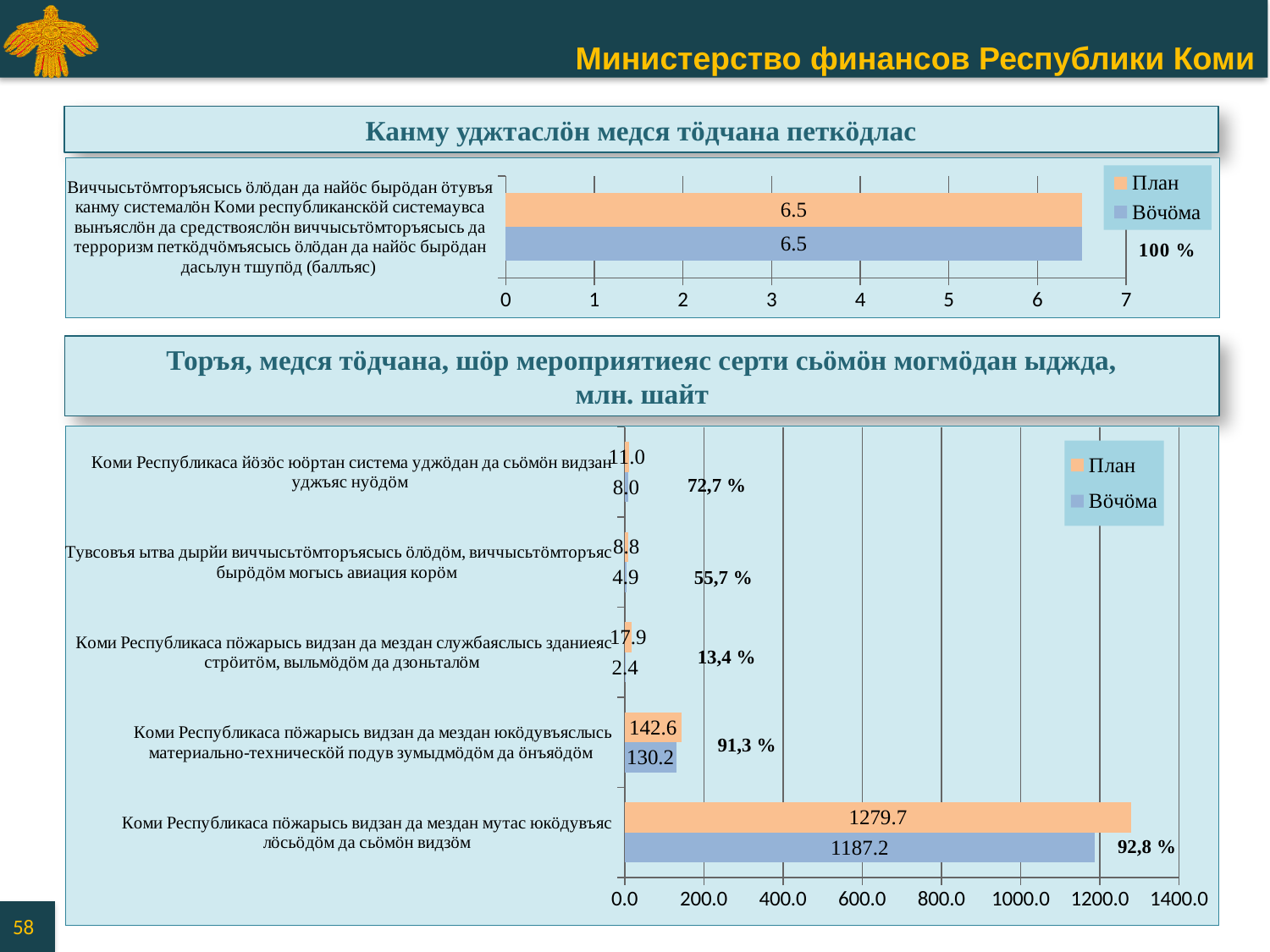
On the bottom chart, what percentage is shown next to the category 'Коми Республикаса пöжарысь видзан да мездан службаяслысь зданиеяс стрöитöм, выльмöдöм да дзоньталöм'? 13,4 % On the bottom chart, which category has the lowest Вöчöма value? Коми Республикаса пöжарысь видзан да мездан службаяслысь зданиеяс стрöитöм, выльмöдöм да дзоньталöм On the bottom chart, which is larger for the category 'Коми Республикаса йöзöс юöртан система уджöдан да сьöмöн видзан уджъяс нуöдöм': the План value or the Вöчöма value? План On the bottom chart, what is the Вöчöма value for the category 'Коми Республикаса пöжарысь видзан да мездан юкöдувъяслысь материально-техническöй подув зумыдмöдöм да öнъяöдöм'? 130.2 How many categories are plotted on the bottom chart? 5 How many series does the legend of the bottom chart list? 2 On the bottom chart, what is the План value for the category 'Тувсовъя ытва дырйи виччысьтöмторъясысь öлöдöм, виччысьтöмторъяс бырöдöм могысь авиация корöм'? 8.8 What type of chart is the top chart? Bar chart On the bottom chart, what is the difference between the План and Вöчöма values for the category 'Коми Республикаса пöжарысь видзан да мездан мутас юкöдувъяс лöсьöдöм да сьöмöн видзöм'? 92.5 What is the Вöчöма value shown on the top chart? 6.5 On the bottom chart, which category has the highest План value? Коми Республикаса пöжарысь видзан да мездан мутас юкöдувъяс лöсьöдöм да сьöмöн видзöм On the bottom chart, what is the План value for the category 'Коми Республикаса пöжарысь видзан да мездан мутас юкöдувъяс лöсьöдöм да сьöмöн видзöм'? 1279.7